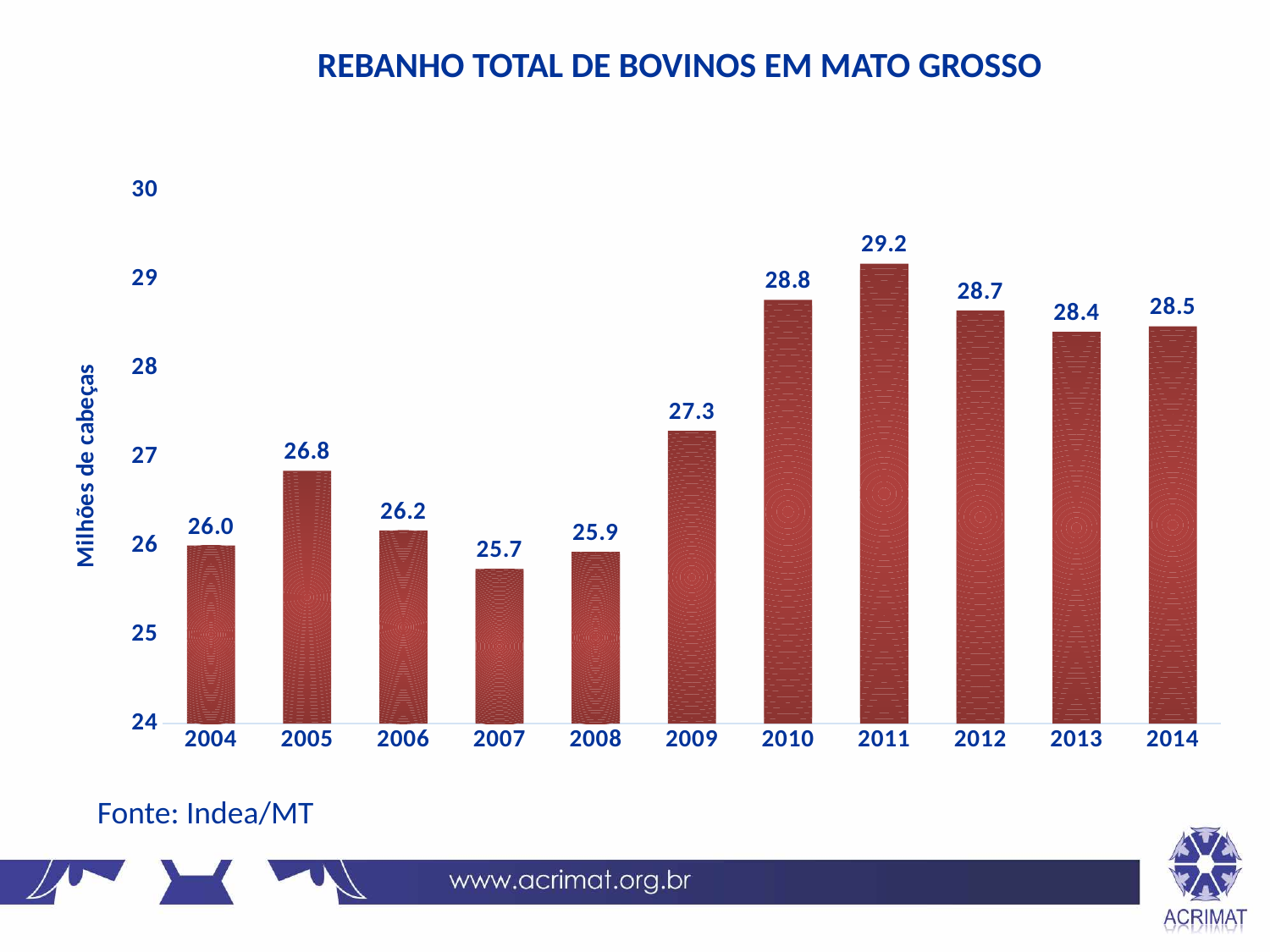
What is the value for 2014? 28.5 How many years are shown on the x axis? 11 What is the difference between the values for 2011 and 2004? 3.2 Is the value for 2009 greater or less than 27? greater What is the value for 2011? 29.2 Which year has the lowest value? 2007 What is the difference between the values for 2010 and 2009? 1.5 What is the value for 2007? 25.7 Which is larger, the value for 2005 or the value for 2008? 2005 What kind of chart is this? bar chart Which year has the highest value? 2011 What is the label of the vertical axis? Milhões de cabeças